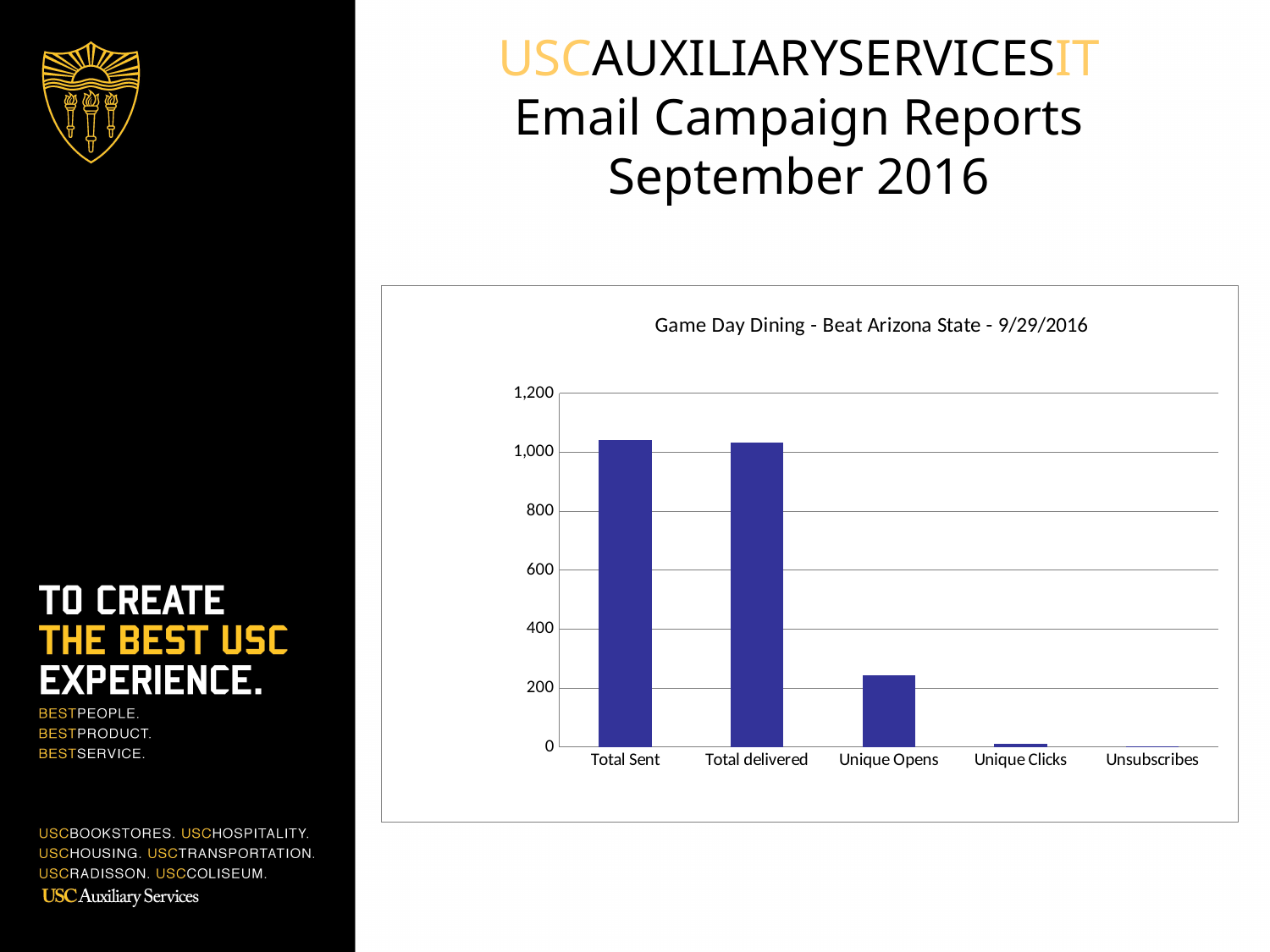
Is the value for Unique Opens greater or less than 200? greater Is the value for Unique Clicks greater or less than 200? less What is the title of the chart? Game Day Dining - Beat Arizona State - 9/29/2016 Is the value for Unique Opens greater or less than 400? less Do the values rise or fall moving from left to right along the x axis? fall Which is larger, the value for Unique Opens or the value for Unique Clicks? Unique Opens Which is larger, the value for Total Sent or the value for Unique Opens? Total Sent What kind of chart is shown on the slide? bar chart How many categories are shown on the x axis of the chart? 5 What colour are the bars in the chart? blue